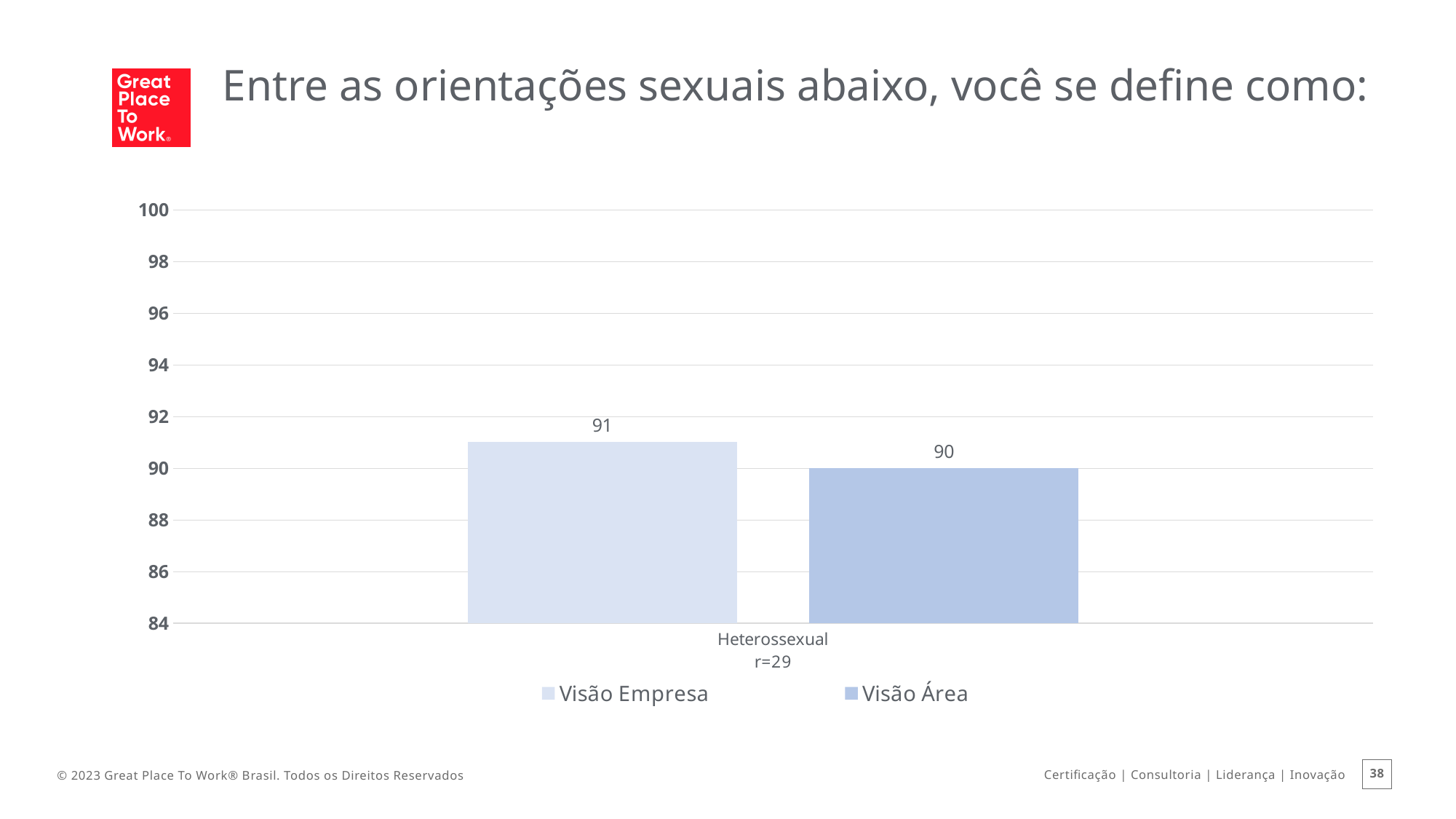
What is the lowest value shown on the y axis? 84 What kind of chart is shown on the slide? bar chart What is the value for Visão Empresa for Heterossexual? 91 What is the category label shown on the x axis? Heterossexual r=29 What is the value for Visão Área for Heterossexual? 90 Which series has the higher value for Heterossexual, Visão Empresa or Visão Área? Visão Empresa Is the value for Visão Área greater or less than 94? less How many categories are shown on the x axis? 1 What is the title of the slide? Entre as orientações sexuais abaixo, você se define como: How many series does the legend list? 2 What is the difference between the Visão Empresa and Visão Área values for Heterossexual? 1 Is the value for Visão Empresa greater or less than 88? greater